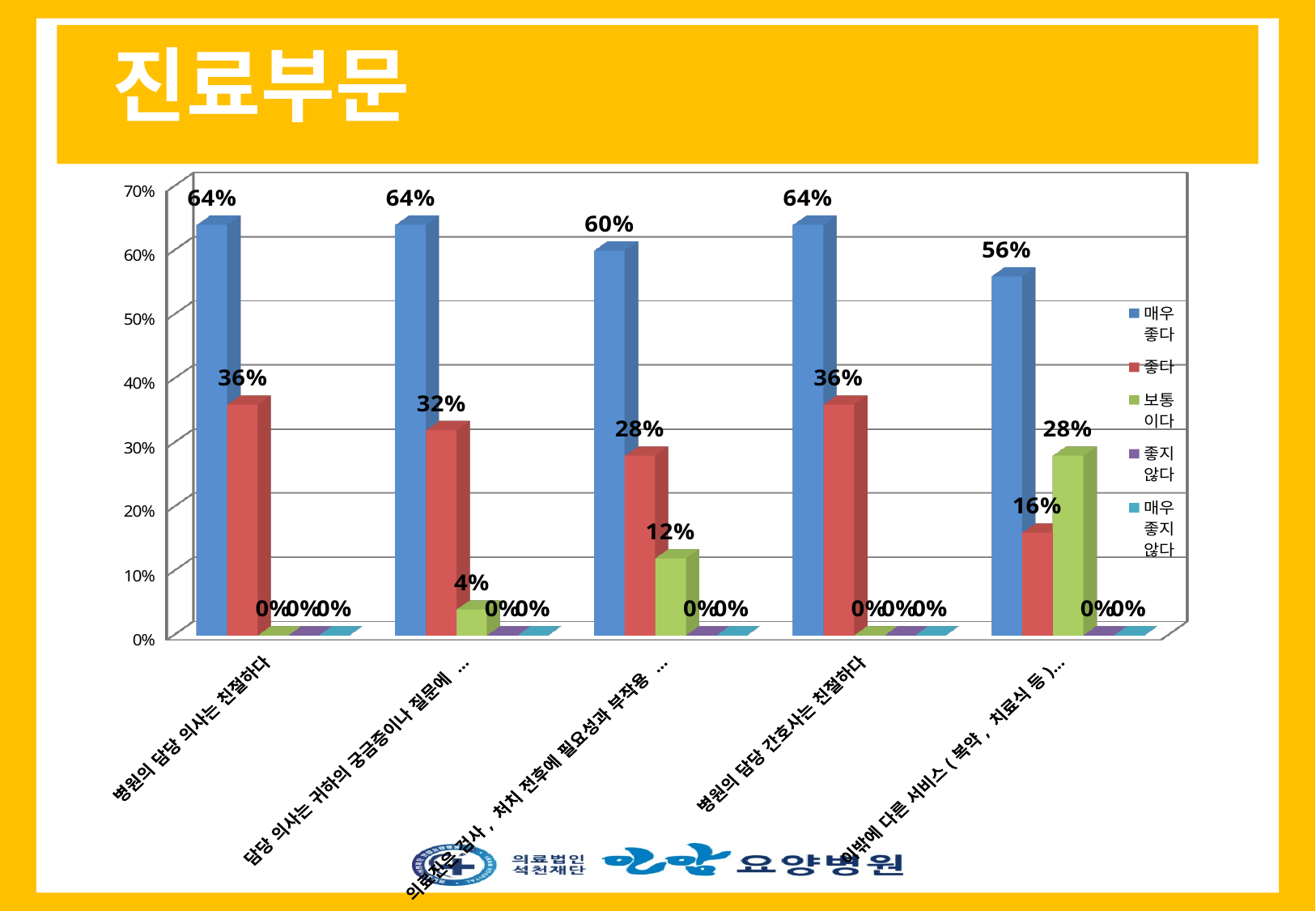
Which category has the lowest value for 매우 좋다? 이밖에 다른 서비스(복약, 치료식 등)… What is the difference between 매우 좋다 and 좋다 for 병원의 담당 의사는 친절하다? 28% What is the value of 매우 좋다 for 병원의 담당 의사는 친절하다? 64% What is the value of 매우 좋다 for 이밖에 다른 서비스(복약, 치료식 등)…? 56% Which is larger for 이밖에 다른 서비스(복약, 치료식 등)…: 좋다 or 보통이다? 보통이다 What is the value of 좋다 for 병원의 담당 간호사는 친절하다? 36% How many categories are shown on the x axis? 5 What is the title of the slide? 진료부문 Which category has the highest value for 보통이다? 이밖에 다른 서비스(복약, 치료식 등)… How many series does the legend list? 5 What kind of chart is shown on the slide? bar chart What is the value of 보통이다 for 이밖에 다른 서비스(복약, 치료식 등)…? 28%